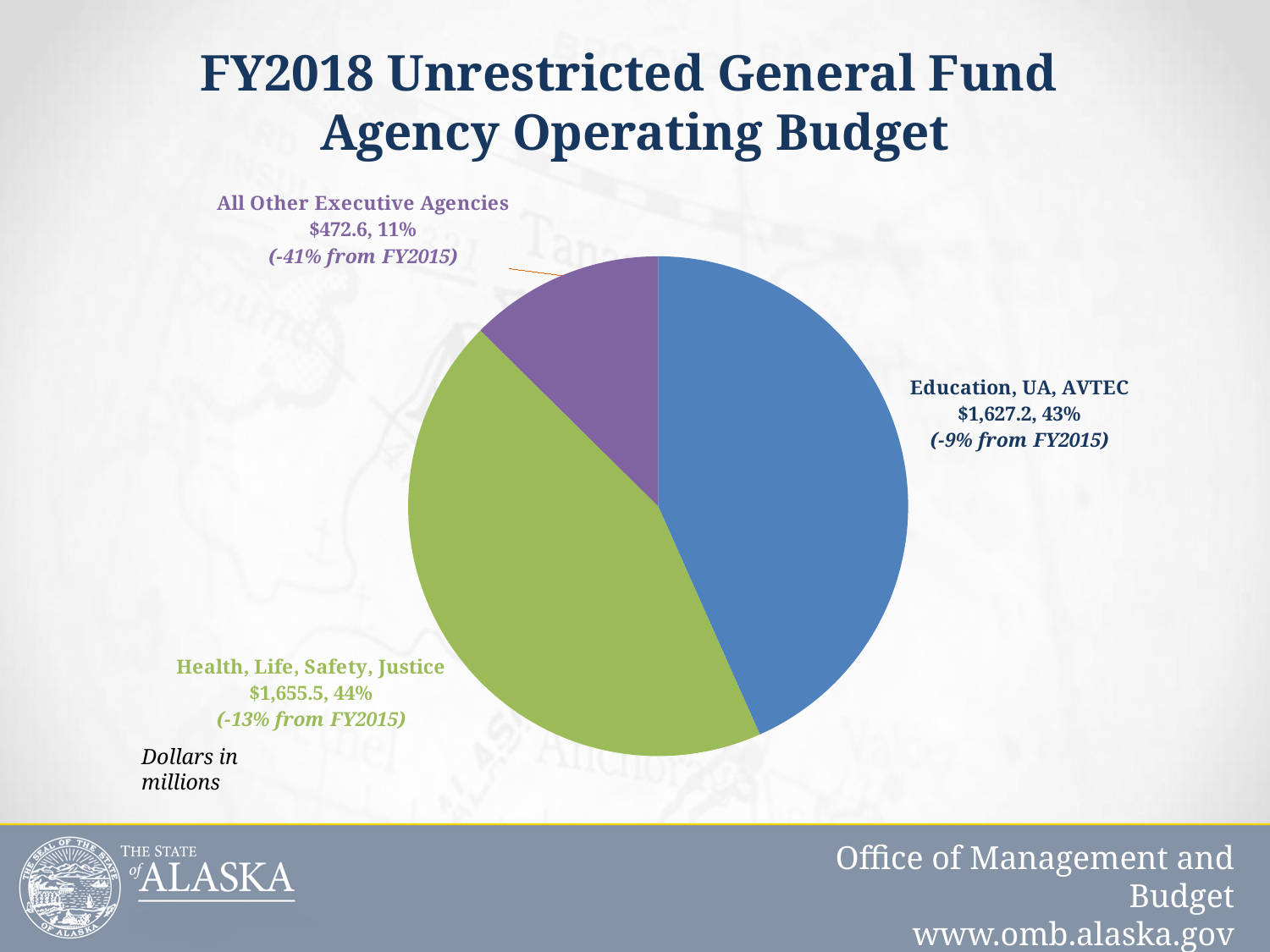
What is the value shown for Health, Life, Safety, Justice? $1,655.5 What share of the pie does All Other Executive Agencies represent? 11% In what units are the dollar values on the chart expressed? Dollars in millions What is the value shown for Education, UA, AVTEC? $1,627.2 What is the value shown for All Other Executive Agencies? $472.6 What kind of chart is shown on the slide? Pie chart Which category has the largest slice of the pie? Health, Life, Safety, Justice Which category has the smallest slice of the pie? All Other Executive Agencies What change from FY2015 is noted for All Other Executive Agencies? -41% from FY2015 What is the difference between the values for Health, Life, Safety, Justice and Education, UA, AVTEC? $28.3 What is the difference between the values for Education, UA, AVTEC and All Other Executive Agencies? $1,154.6 What share of the pie does Education, UA, AVTEC represent? 43%